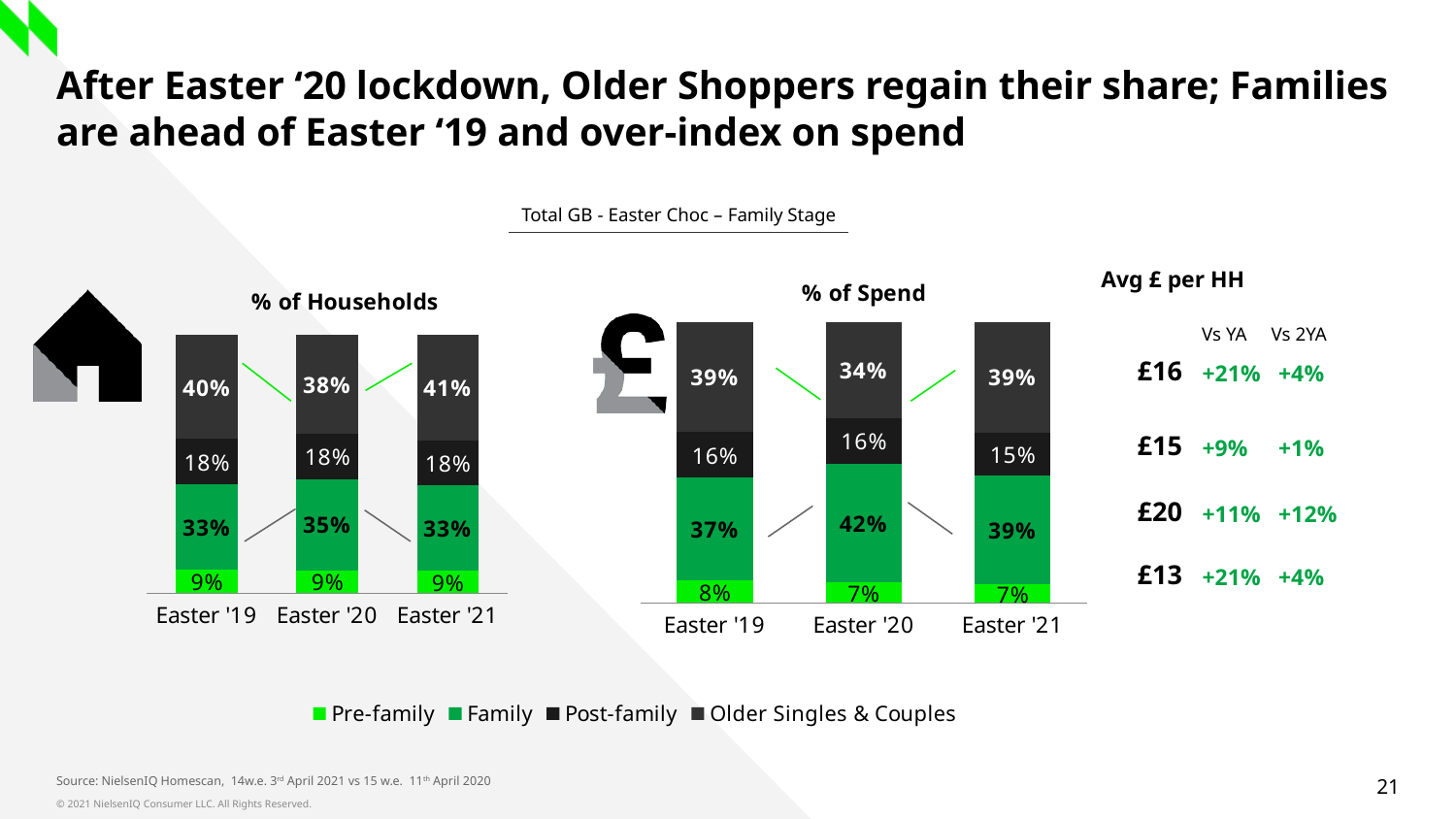
How many series does the legend list? 4 In the % of Households chart, is the Older Singles & Couples value larger for Easter '21 or Easter '20? Easter '21 In the % of Households chart, what is the Older Singles & Couples value for Easter '21? 41% In the % of Spend chart, what is the total of the Easter '19 stacked bar? 100% In the % of Spend chart, which Easter has the lowest Older Singles & Couples value? Easter '20 In the % of Spend chart, what is the Family value for Easter '20? 42% In the % of Spend chart, what is the difference between the Family value for Easter '20 and Easter '19? 5% How many categories are shown on the x axis of the % of Spend chart? 3 In the % of Households chart, what is the Post-family value for Easter '20? 18% In the % of Spend chart, what is the Pre-family value for Easter '19? 8% In the % of Households chart, which Easter has the highest Family value? Easter '20 What kind of chart is the % of Households chart? Stacked bar chart